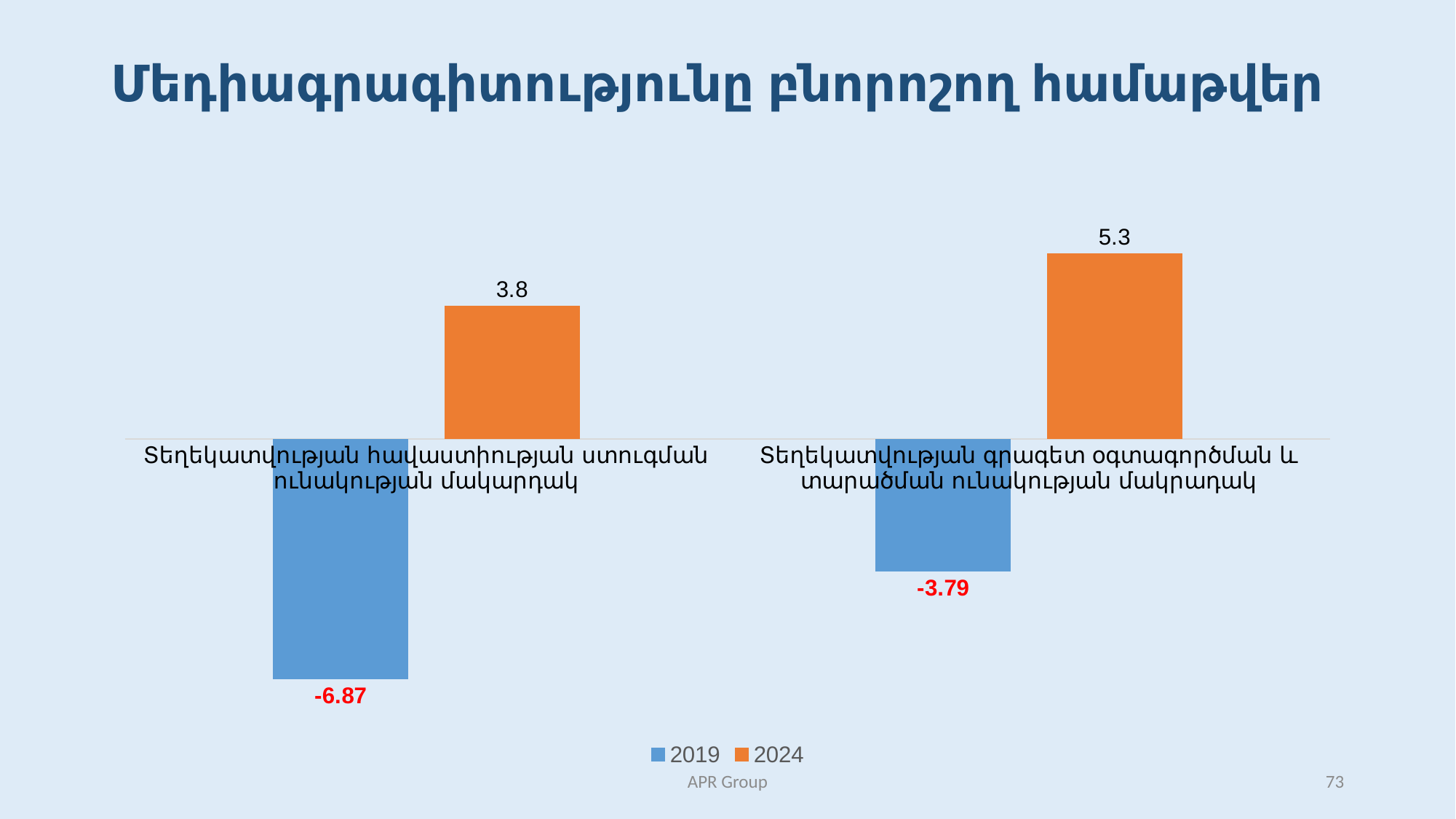
What is the 2019 value for "Տեղեկատվության հավաստիության ստուգման ունակության մակարդակ"? -6.87 What type of chart is shown on the slide? bar chart What is the difference between the 2024 and 2019 values for "Տեղեկատվության հավաստիության ստուգման ունակության մակարդակ"? 10.67 What is the 2024 value for "Տեղեկատվության գրագետ օգտագործման և տարածման ունակության մակրադակ"? 5.3 Which category has the lowest 2019 value? Տեղեկատվության հավաստիության ստուգման ունակության մակարդակ How many categories are shown on the x axis? 2 Is the 2019 value for the left category larger or smaller than the 2019 value for the right category? smaller What is the 2019 value for "Տեղեկատվության գրագետ օգտագործման և տարածման ունակության մակրադակ"? -3.79 What is the difference between the 2024 values of the two categories? 1.5 Which category has the highest 2024 value? Տեղեկատվության գրագետ օգտագործման և տարածման ունակության մակրադակ How many series does the legend list? 2 What is the 2024 value for "Տեղեկատվության հավաստիության ստուգման ունակության մակարդակ"? 3.8